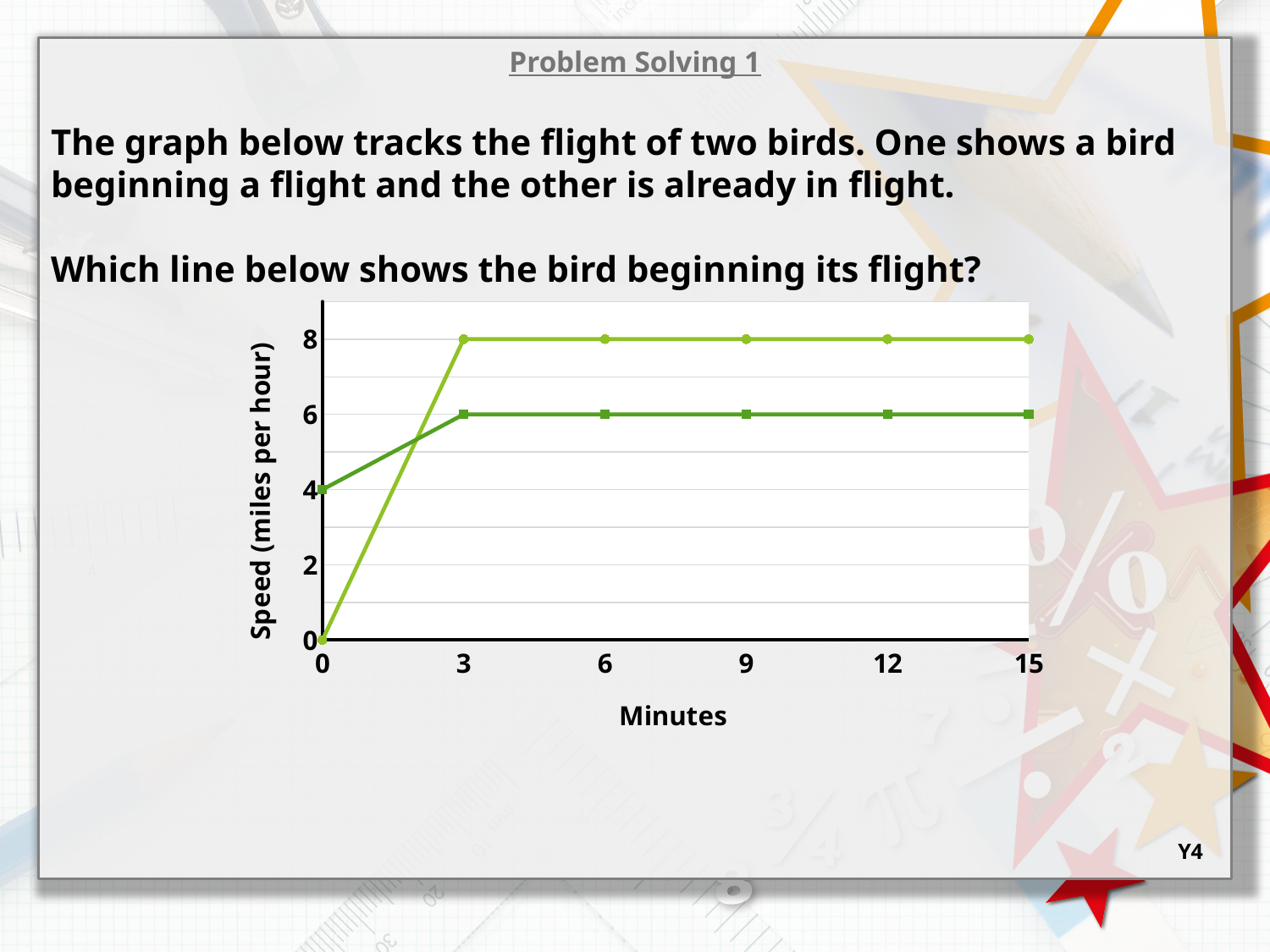
What is the label of the horizontal axis of the chart? Minutes Which line has the higher speed at 12 minutes, the one with circle markers or the one with square markers? circle markers How many time points are plotted along the horizontal axis? 6 What is the label of the vertical axis of the chart? Speed (miles per hour) What is the speed of the line with square markers at 15 minutes? 6 What kind of chart is shown on the slide? line chart Does the speed of the line with circle markers rise or fall between 0 and 3 minutes? rise What is the difference in speed between the two lines at 9 minutes? 2 What is the speed of the line with square markers at 0 minutes? 4 Which line has the higher speed at 0 minutes, the one with circle markers or the one with square markers? square markers What is the speed of the line with circle markers at 3 minutes? 8 What is the speed of the line with circle markers at 0 minutes? 0